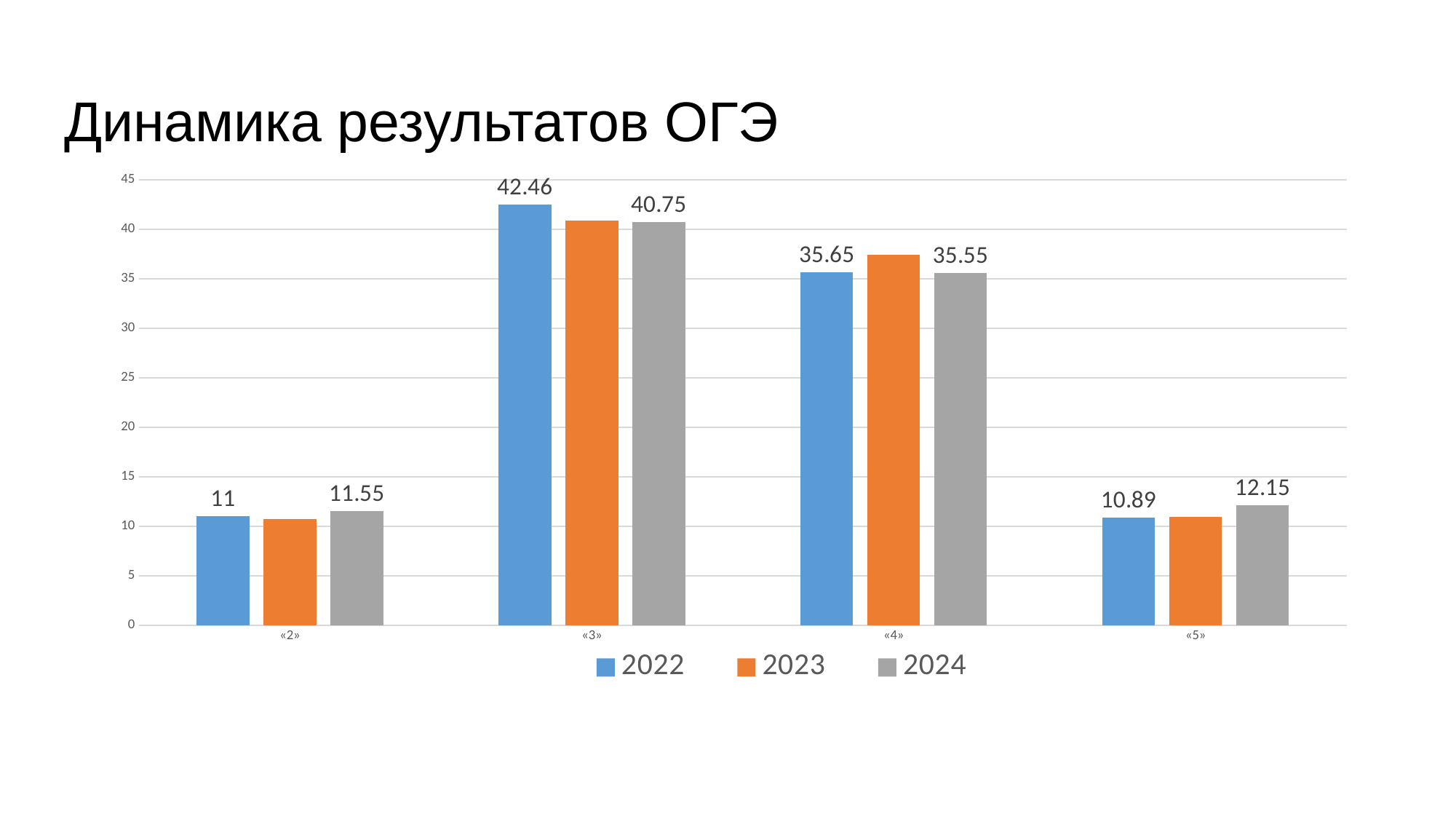
In the 2024 series, which is larger: the value for «5» or the value for «2»? «5» What type of chart is shown on the slide? bar chart Which category has the highest value in the 2022 series? «3» How many categories are shown on the x axis? 4 What is the value for «3» in the 2022 series? 42.46 Which category has the lowest value in the 2022 series? «5» How many series does the legend list? 3 What is the value for «2» in the 2024 series? 11.55 What is the difference between the 2022 and 2024 values for «3»? 1.71 Is the value for «4» in the 2023 series greater or less than 35? greater What is the value for «5» in the 2024 series? 12.15 What is the value for «4» in the 2022 series? 35.65